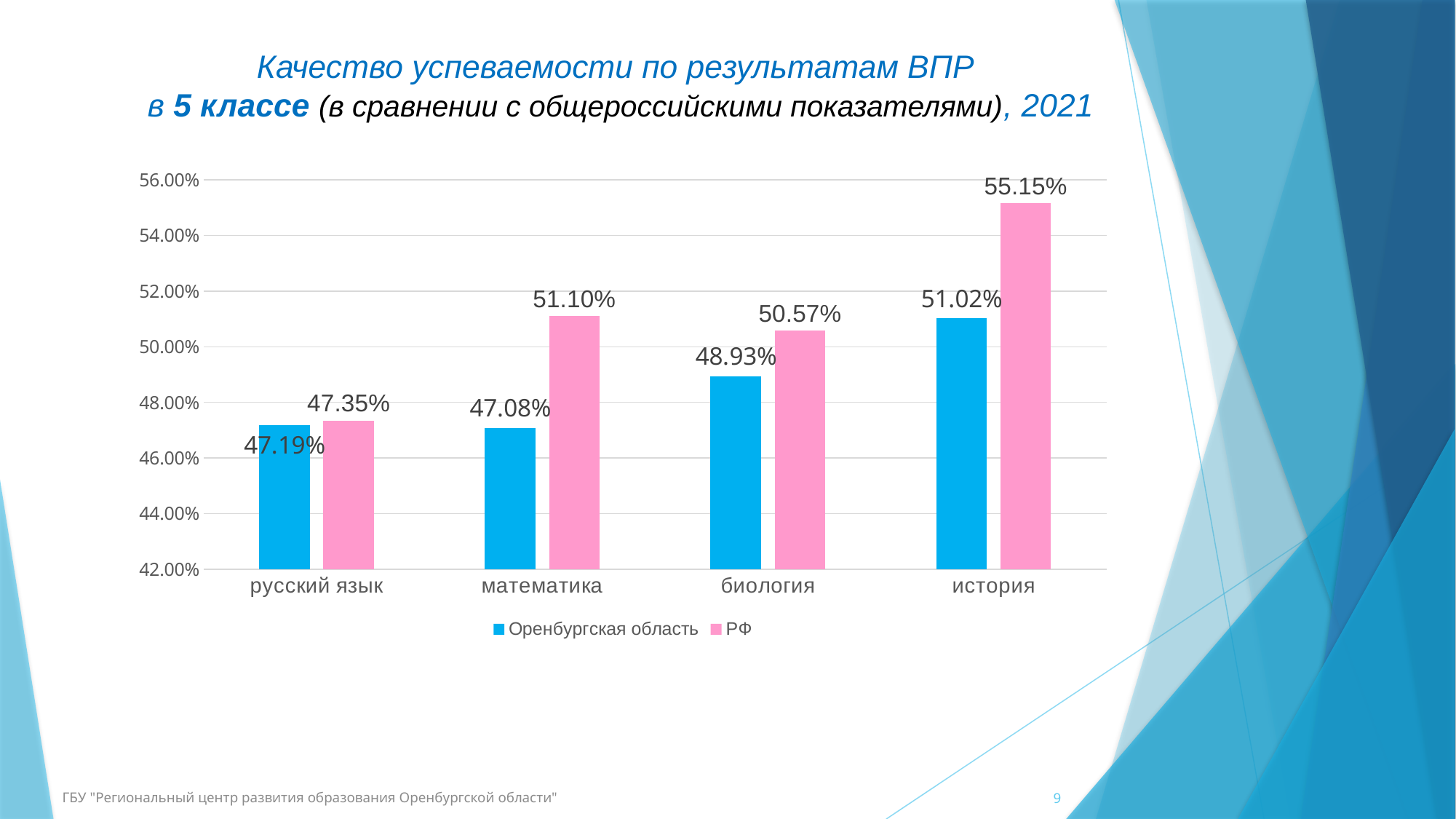
How many subjects are shown on the x axis? 4 What is the value for РФ in математика? 51.10% In which subject is the РФ value highest? история Is the value for РФ in история greater or less than 54.00%? greater What is the value for Оренбургская область in история? 51.02% What is the difference between the РФ and Оренбургская область values in история? 4.13% Which is larger in биология: the value for Оренбургская область or for РФ? РФ How many series does the legend list? 2 What kind of chart is shown on the slide? bar chart In which subject is the Оренбургская область value lowest? математика What is the value for Оренбургская область in биология? 48.93% What is the value for РФ in русский язык? 47.35%